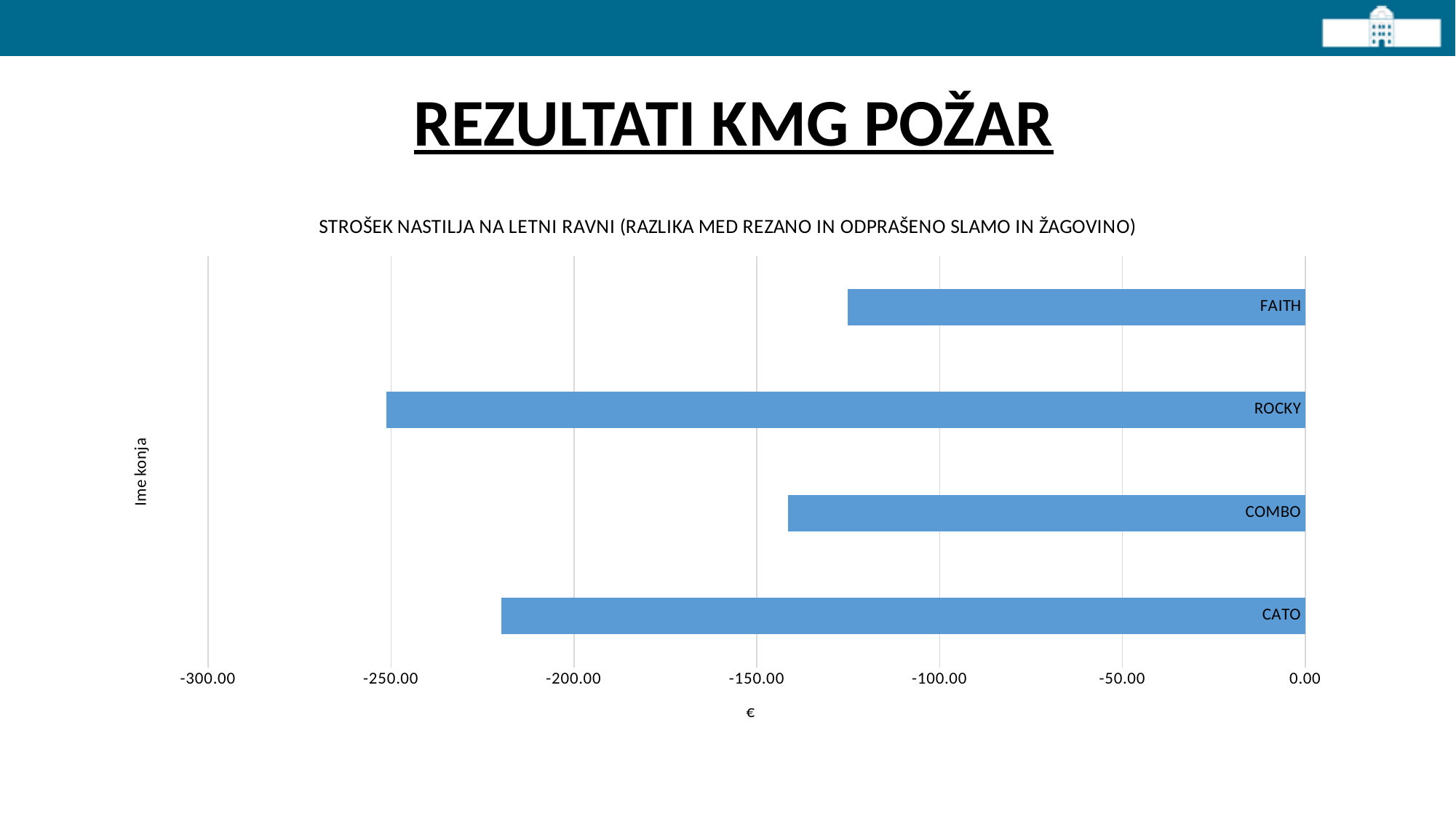
What kind of chart is shown on the slide? bar chart Which horse has the longest bar (the most negative value) in the chart? ROCKY Is the value for COMBO greater or less than -150.00? greater Which horse has the shortest bar (the value closest to 0.00) in the chart? FAITH Is the value for CATO greater or less than -200.00? less How many horses (categories) are plotted in the chart? 4 What is the label of the vertical axis of the chart? Ime konja Which bar is longer, FAITH or COMBO? COMBO Which bar is longer, CATO or COMBO? CATO What is the title of the chart? STROŠEK NASTILJA NA LETNI RAVNI (RAZLIKA MED REZANO IN ODPRAŠENO SLAMO IN ŽAGOVINO) Is the value for FAITH greater or less than -100.00? less